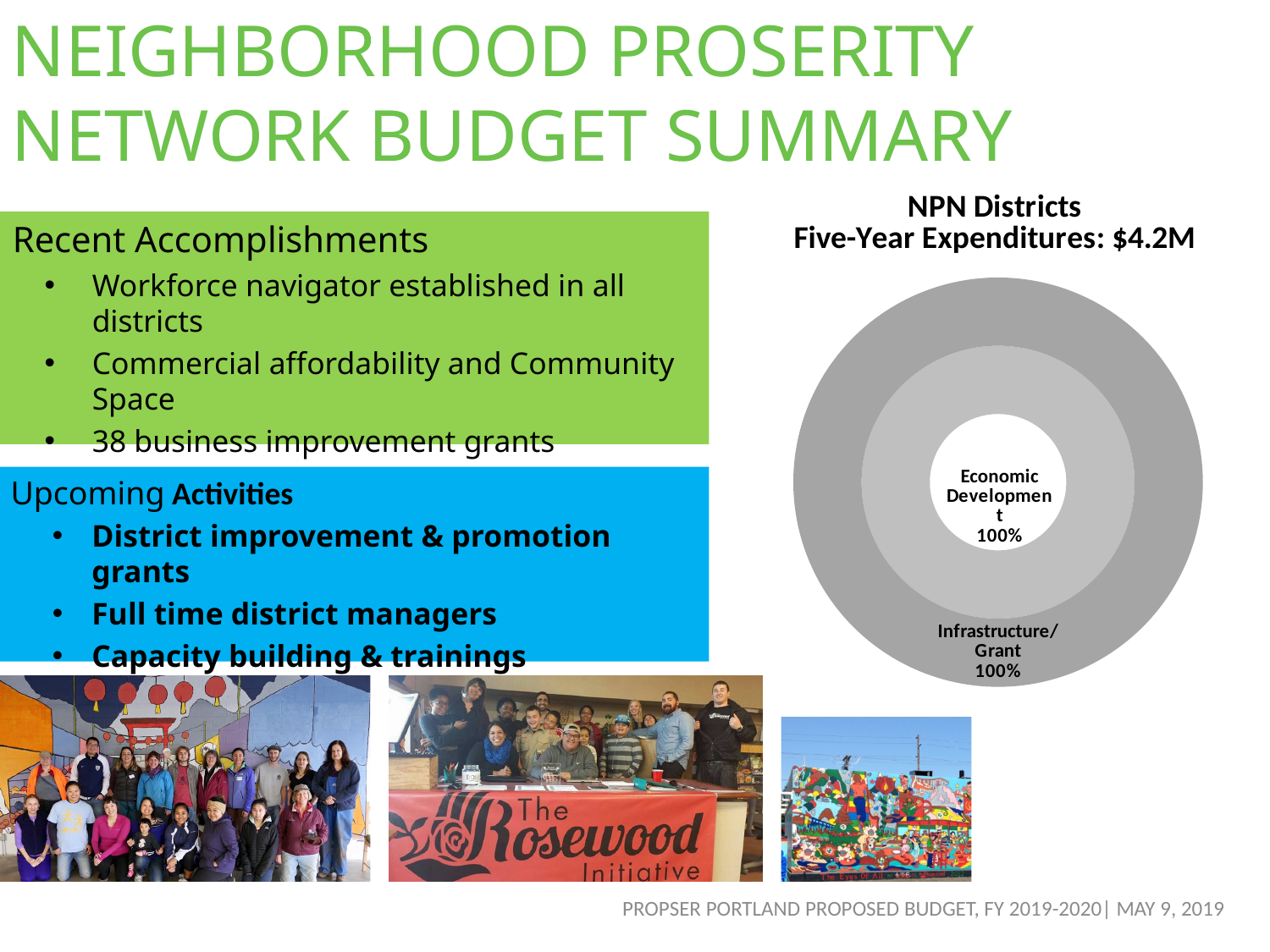
What percentage is shown for Economic Development in the chart? 100% What is the share of the Economic Development ring shown in the chart? 100% How many rings does the doughnut chart have? 2 Is the value shown for Economic Development greater or less than 50%? greater Which category label appears in the inner ring of the doughnut chart? Economic Development What percentage is shown for Infrastructure/Grant in the chart? 100% What type of chart is shown on the slide? Doughnut chart How many labeled categories are shown in the chart? 2 What is the title of the chart on the slide? NPN Districts Five-Year Expenditures: $4.2M Which category label appears in the outer ring of the doughnut chart? Infrastructure/Grant What total five-year expenditure amount is stated in the chart title? $4.2M